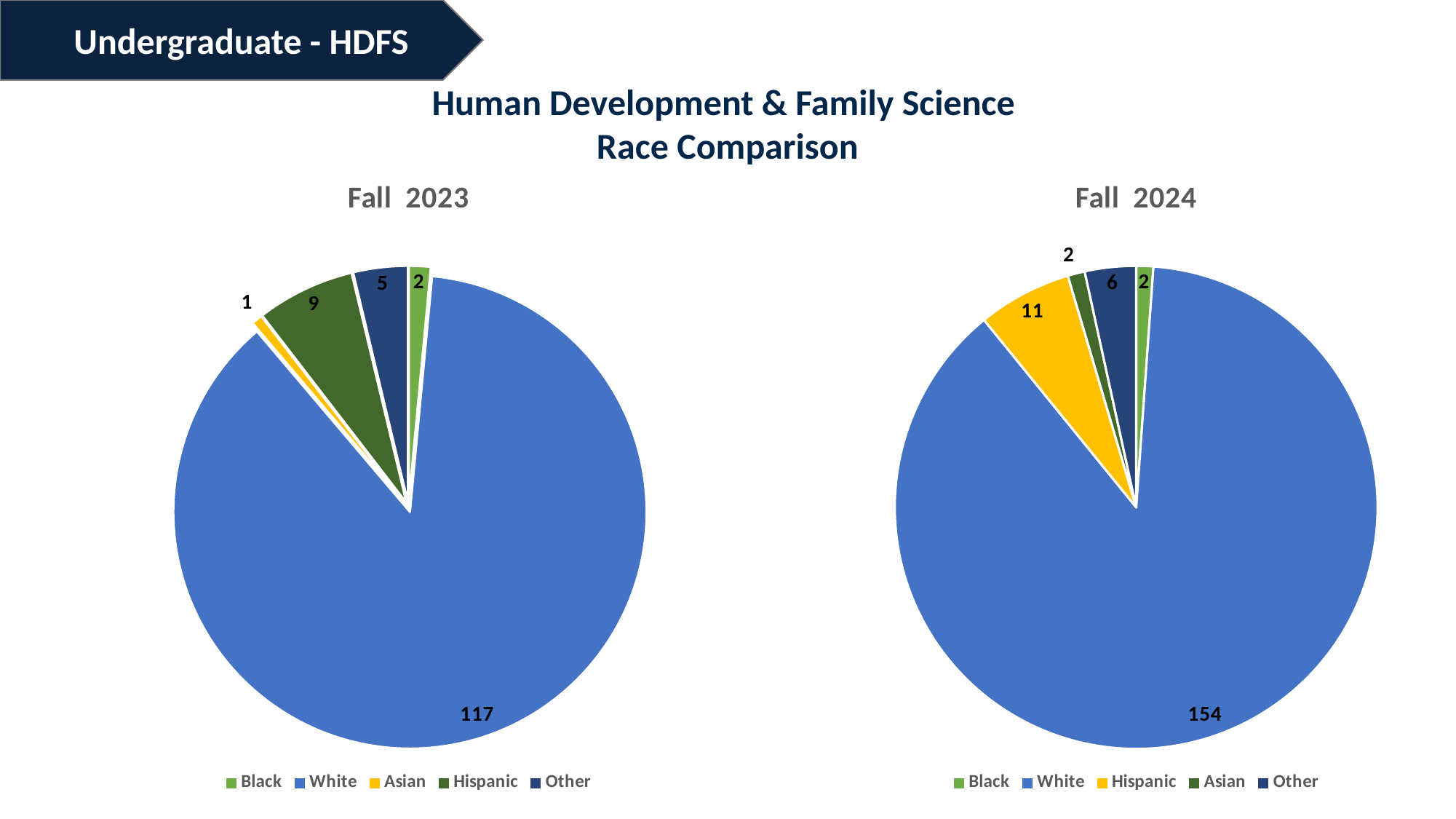
In the Fall 2023 chart, which category has the smallest slice? Asian In the Fall 2024 chart, which is larger, Hispanic or Other? Hispanic In the Fall 2024 chart, which category has the largest slice? White What type of chart is the Fall 2024 chart? Pie chart In the Fall 2024 chart, what is the value for Other? 6 In the Fall 2023 chart, what is the value for White? 117 In the Fall 2024 chart, what is the value for Hispanic? 11 What is the difference between the White values in the Fall 2024 chart and the Fall 2023 chart? 37 What is the total of all slices in the Fall 2024 chart? 175 What share of the Fall 2024 pie is White? 88% In the Fall 2023 chart, what is the value for Hispanic? 9 How many categories does the Fall 2023 chart show? 5